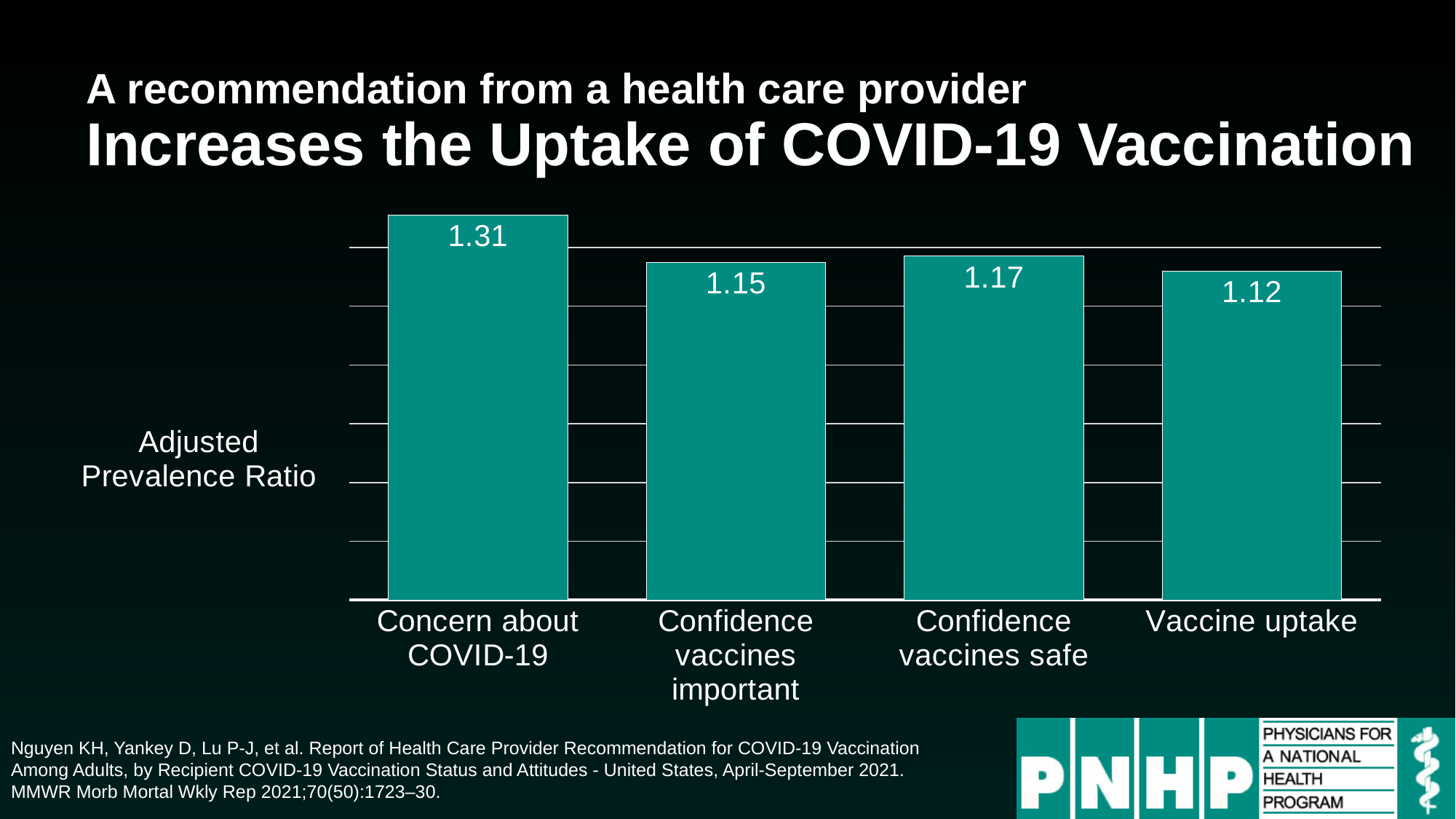
What kind of chart is shown on the slide? Bar chart What is the difference between the adjusted prevalence ratios for Concern about COVID-19 and Vaccine uptake? 0.19 Which category has the lowest adjusted prevalence ratio? Vaccine uptake What is the adjusted prevalence ratio for Confidence vaccines important? 1.15 What is the adjusted prevalence ratio for Vaccine uptake? 1.12 What is the adjusted prevalence ratio for Confidence vaccines safe? 1.17 How many categories are shown in the chart? 4 What is the adjusted prevalence ratio for Concern about COVID-19? 1.31 Which has a larger adjusted prevalence ratio, Confidence vaccines safe or Vaccine uptake? Confidence vaccines safe What is the label on the vertical axis of the chart? Adjusted Prevalence Ratio What is the difference between the adjusted prevalence ratios for Confidence vaccines safe and Confidence vaccines important? 0.02 Which category has the highest adjusted prevalence ratio? Concern about COVID-19